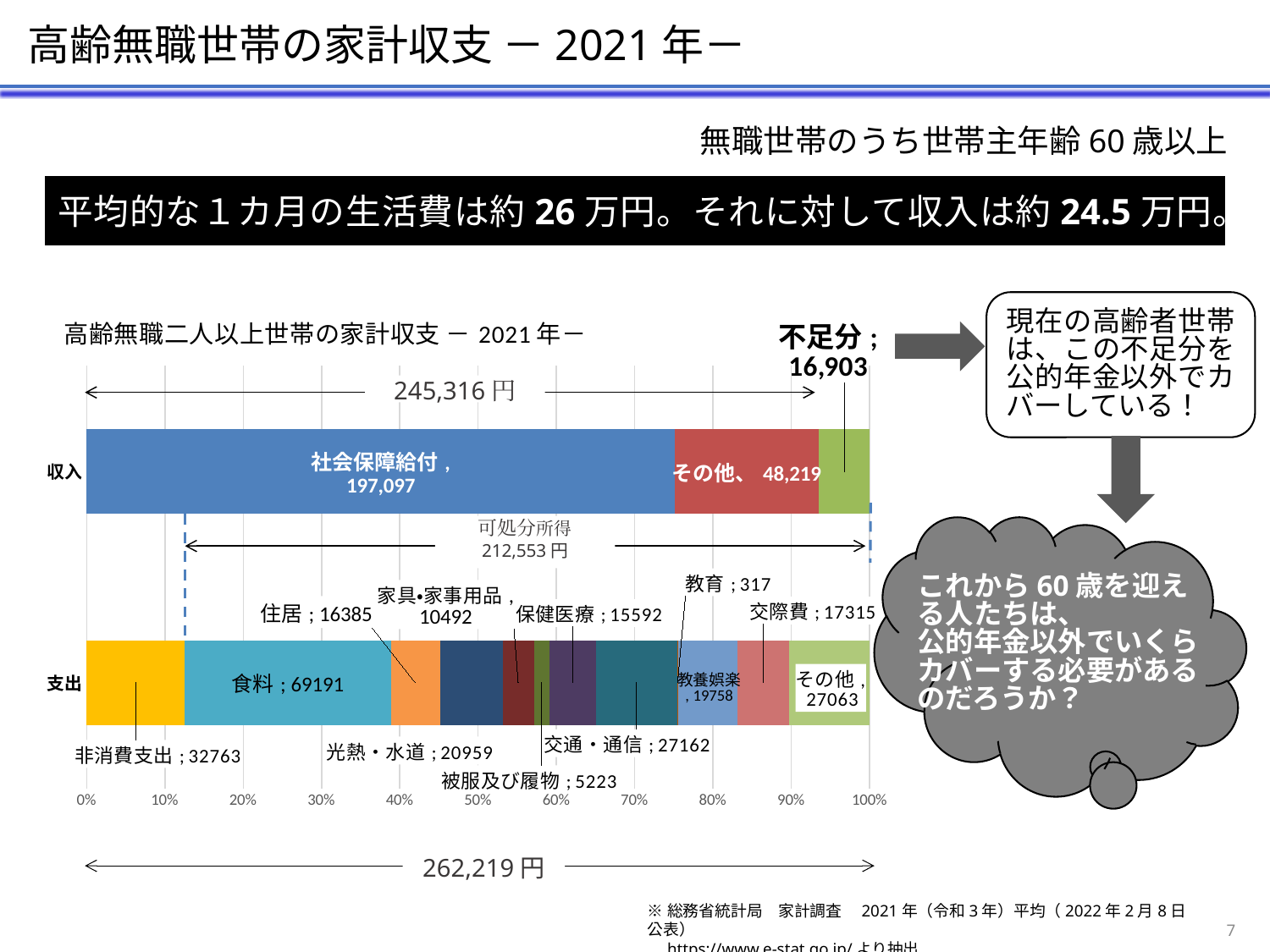
In the chart, which is larger in the 支出 bar: 交通・通信 or 光熱・水道? 交通・通信 What is the title of the chart on the slide? 高齢無職二人以上世帯の家計収支 － 2021 年－ How many segments make up the 支出 bar in the chart? 12 In the chart, which segment of the 支出 bar has the largest value? 食料 In the chart, what is the value labelled 不足分? 16,903 In the chart, what is the value of 可処分所得? 212,553 円 In the chart, what is the difference between 社会保障給付 and その他 in the 収入 bar? 148,878 In the chart, what is the value of 食料 in the 支出 bar? 69191 What kind of chart is shown on the slide? Stacked bar chart In the chart, what is the value of 社会保障給付 in the 収入 bar? 197,097 In the chart, which segment of the 支出 bar has the smallest value? 教育 In the chart, what is the total shown for the 支出 bar? 262,219 円